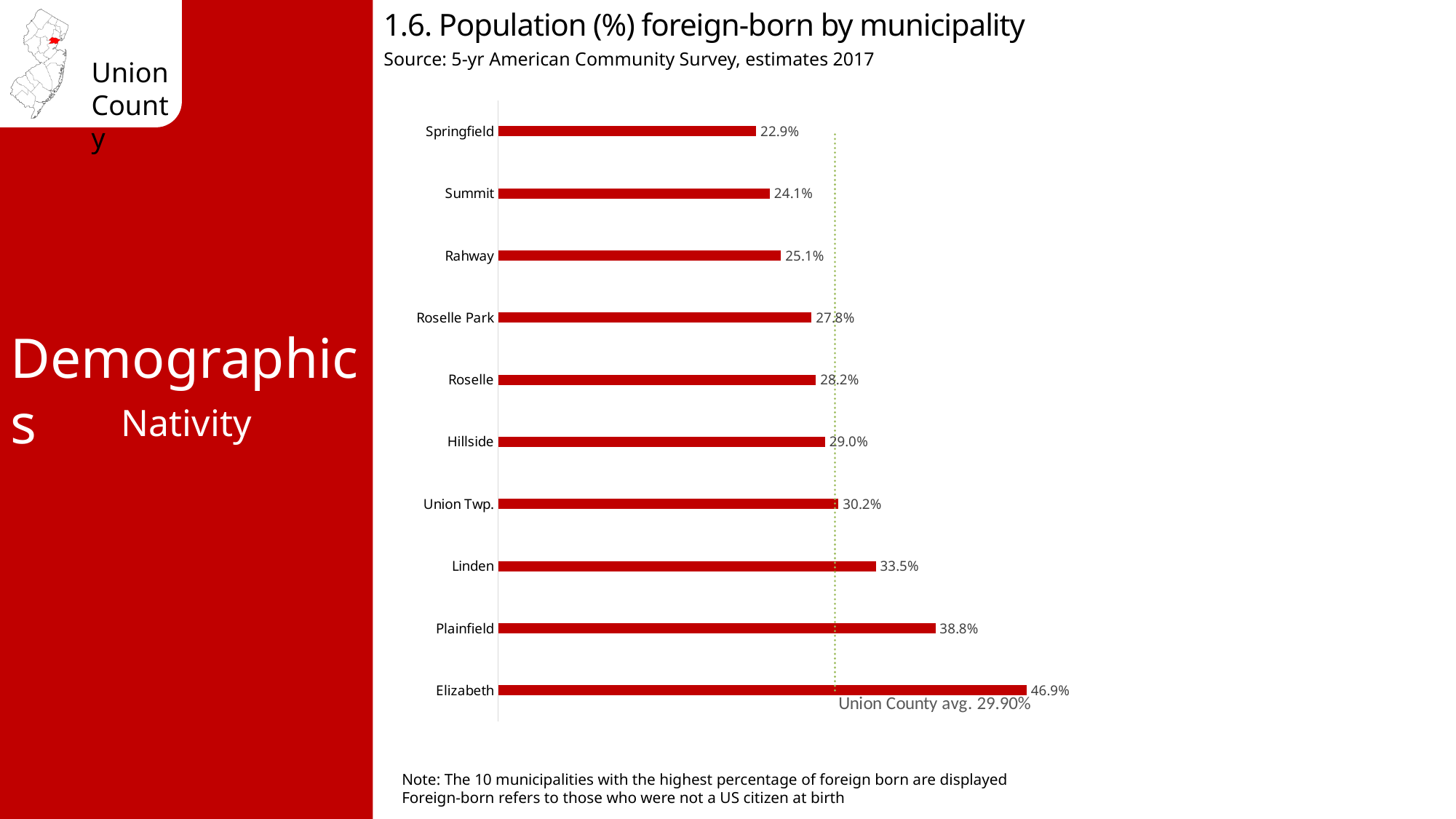
Which municipality has the lowest percentage of foreign-born population shown on the chart? Springfield How many municipalities are shown on the chart? 10 What is the Union County average foreign-born percentage marked by the dotted line? 29.90% What is the percentage of foreign-born population in Summit? 24.1% What kind of chart is shown on the slide? Bar chart What is the percentage of foreign-born population in Elizabeth? 46.9% Which has a higher foreign-born percentage, Rahway or Roselle? Roselle What is the percentage of foreign-born population in Roselle Park? 27.8% Which municipality has the highest percentage of foreign-born population? Elizabeth What is the difference in foreign-born percentage between Linden and Hillside? 4.5% What is the source of the data shown in the chart? 5-yr American Community Survey, estimates 2017 What is the difference in foreign-born percentage between Elizabeth and Plainfield? 8.1%